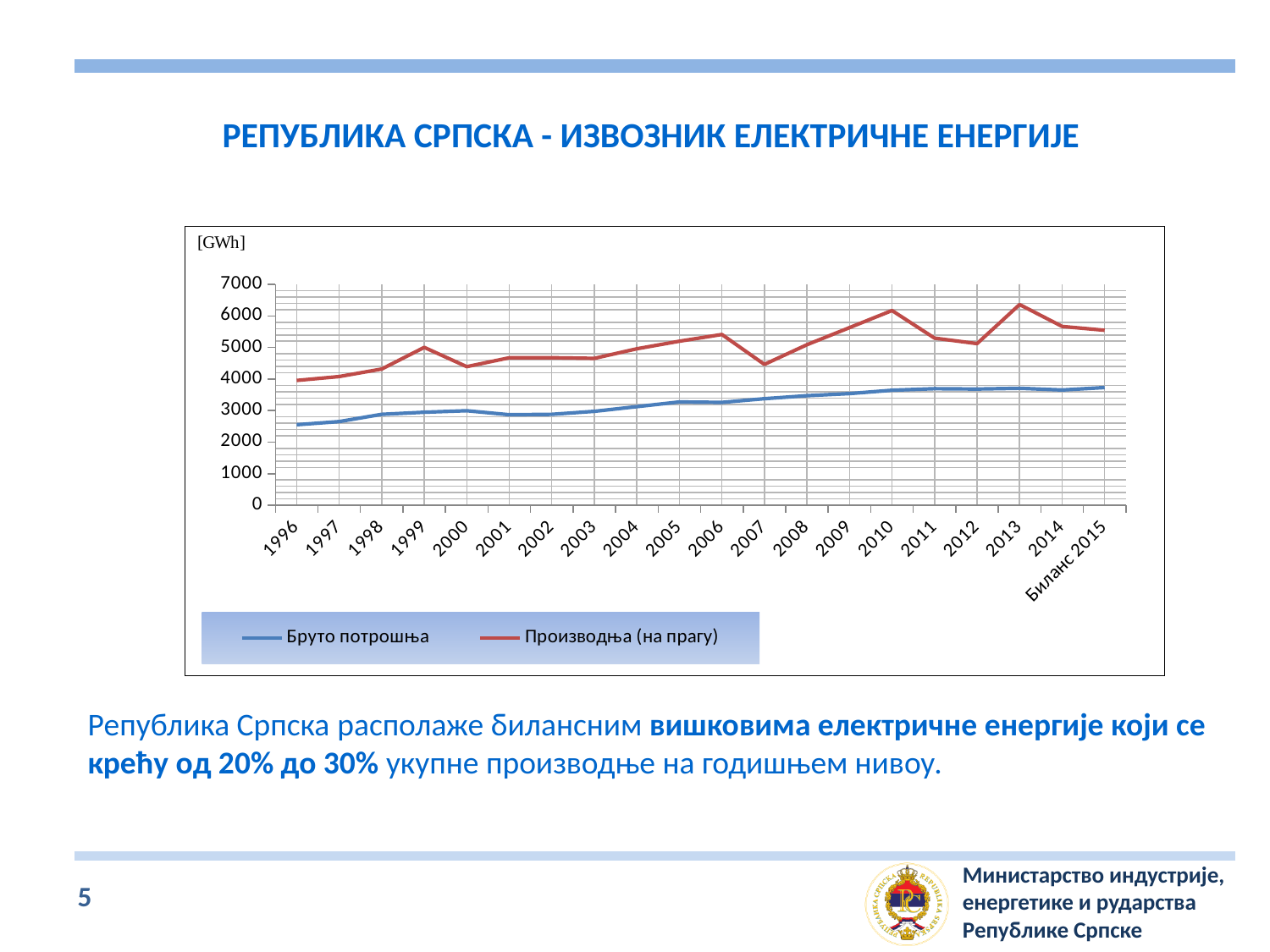
Is the value for Производња (на прагу) in 2013 greater or less than 6000? greater Which series has the higher value in 2010, Бруто потрошња or Производња (на прагу)? Производња (на прагу) How many points are plotted along the x axis of the chart? 20 Is the value for Бруто потрошња in 2010 greater or less than 3000? greater Is the value for Производња (на прагу) in 2007 greater or less than 5000? less Does Бруто потрошња generally rise or fall from 1996 to Биланс 2015? rise How many series does the chart legend list? 2 In which year is Производња (на прагу) at its lowest? 1996 Which series is drawn in red on the chart? Производња (на прагу) What kind of chart is shown on the slide? line chart What unit is shown on the chart's y axis? [GWh]